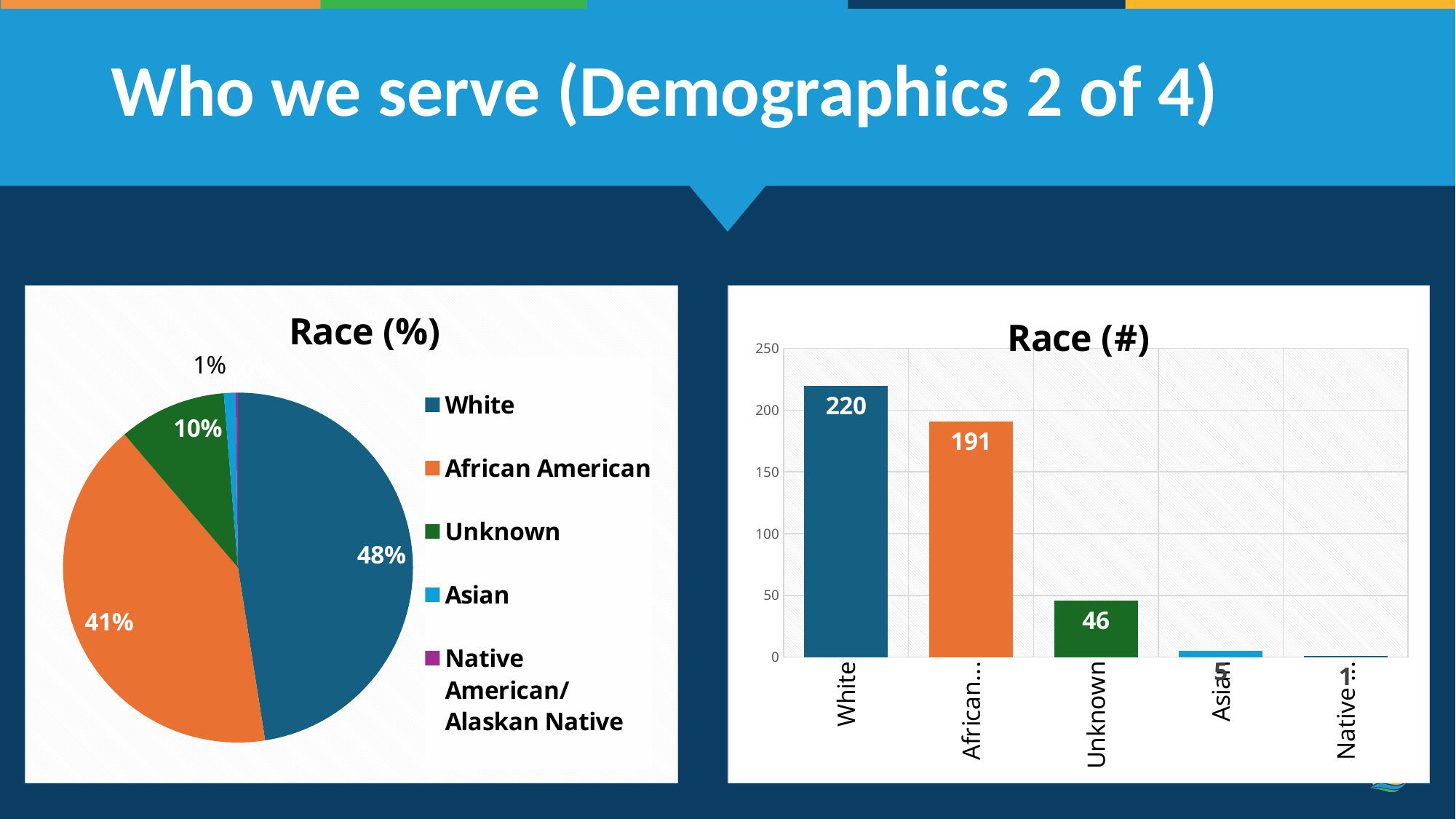
What kind of chart is the Race (#) chart? Bar chart In the Race (%) chart, which category has the largest slice? White What kind of chart is the Race (%) chart? Pie chart In the Race (#) chart, what is the value for White? 220 In the Race (#) chart, what is the value for Unknown? 46 In the Race (#) chart, which is larger, the value for African American or the value for Unknown? African American In the Race (%) chart, what percentage is shown for African American? 41% In the Race (%) chart, how many categories does the legend list? 5 In the Race (#) chart, is the value for Asian greater or less than 50? less In the Race (%) chart, what percentage is shown for Unknown? 10% In the Race (%) chart, what percentage is shown for White? 48% In the Race (#) chart, what is the difference between the White and African American values? 29